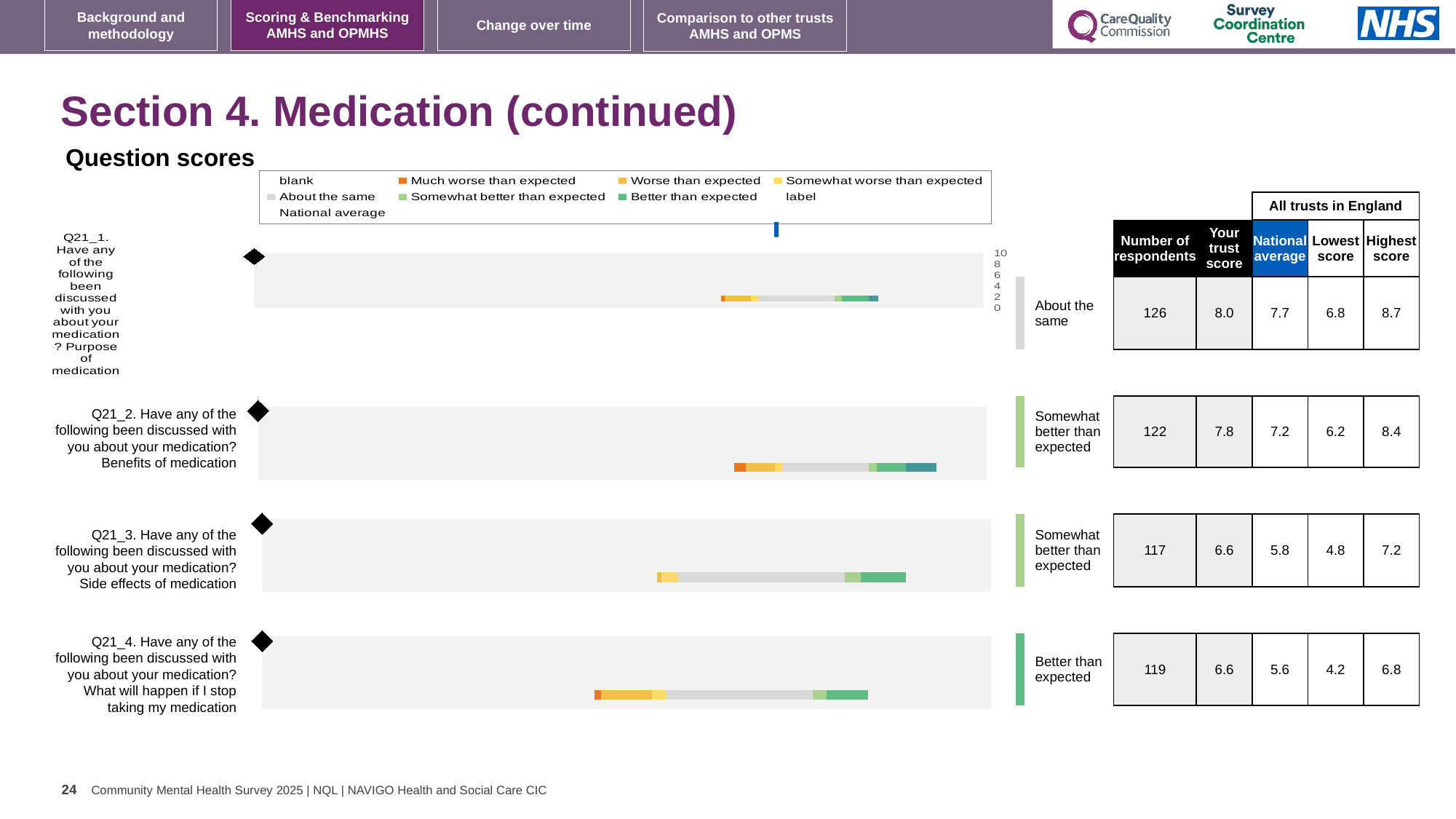
For the Q21_2 (Benefits of medication) chart, what is the difference between the trust's score and the national average? 0.6 How many entries does the shared legend above the charts list? 9 Which of the four questions has the lowest number of respondents in the table? Q21_3 (Side effects of medication) What benchmark label is printed next to the Q21_4 (What will happen if I stop taking my medication) chart? Better than expected Which of the four questions has the highest trust score in the table? Q21_1 (Purpose of medication) For the Q21_1 (Purpose of medication) chart, what is the trust's score shown in the table? 8.0 What kind of chart is used for each question score on this slide? bar chart For the Q21_4 (What will happen if I stop taking my medication) chart, what is the highest score across all trusts in England? 6.8 For the Q21_1 (Purpose of medication) chart, what is the number of respondents shown in the table? 126 For the Q21_3 (Side effects of medication) chart, what is the national average shown in the table? 5.8 What benchmark label is printed next to the Q21_1 (Purpose of medication) chart? About the same How many question charts (Q21_1 to Q21_4) are shown on the slide? 4